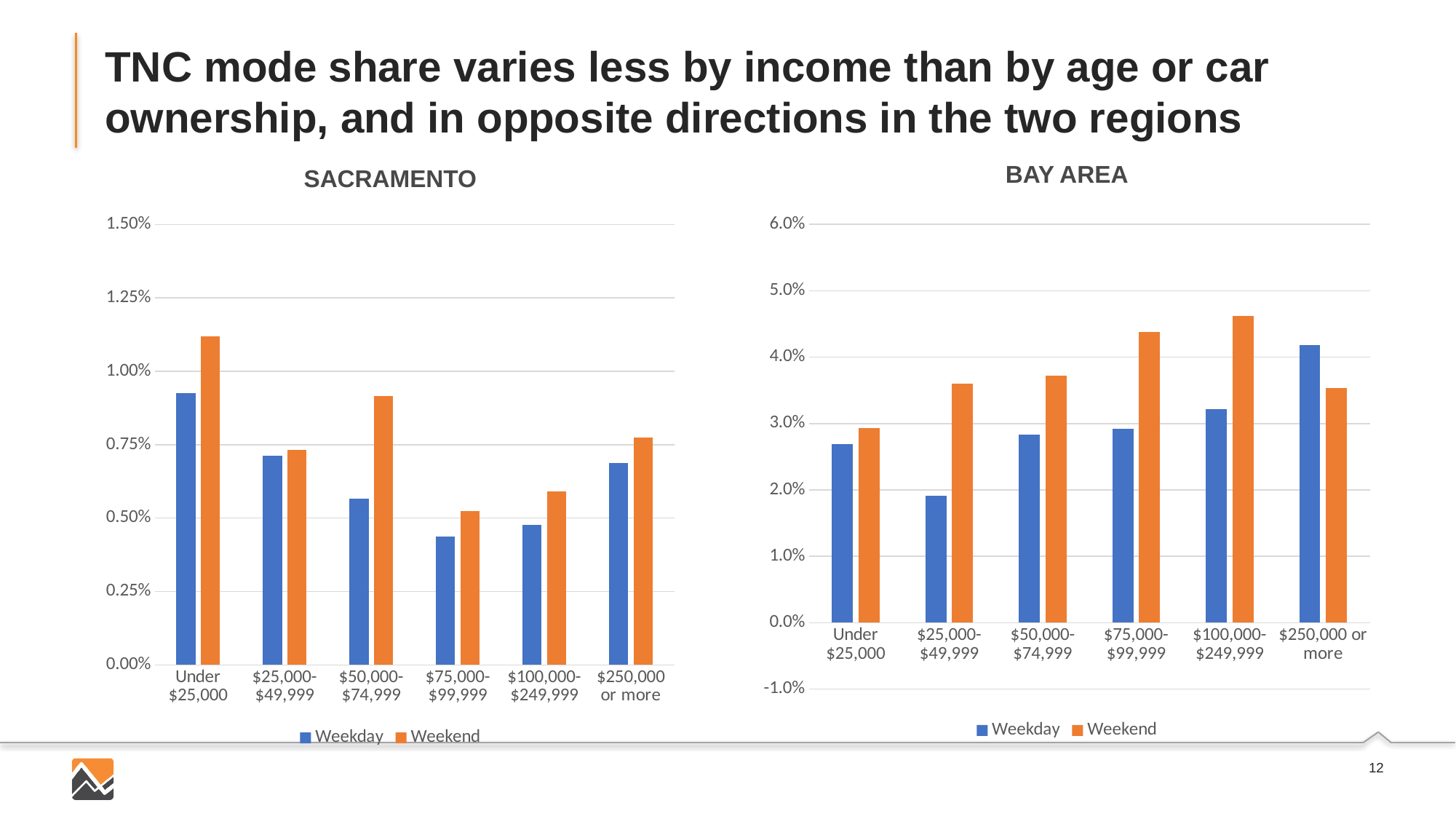
In the Sacramento chart, is the Weekday value for $75,000-$99,999 greater or less than 0.50%? less In the Bay Area chart, for the $250,000 or more category, which is larger: Weekday or Weekend? Weekday In the Bay Area chart, which income category has the highest Weekday value? $250,000 or more In the Bay Area chart, is the Weekend value for $25,000-$49,999 greater or less than 3.0%? greater How many income categories are shown on the x axis of the Sacramento chart? 6 In the Bay Area chart, is the Weekday value for $250,000 or more greater or less than 4.0%? greater In the Sacramento chart, for the $50,000-$74,999 category, which is larger: Weekday or Weekend? Weekend How many series does the legend of the Bay Area chart list? 2 What kind of chart is the Sacramento chart? bar chart In the Sacramento chart, which income category has the highest Weekend value? Under $25,000 In the Bay Area chart, which income category has the lowest Weekday value? $25,000-$49,999